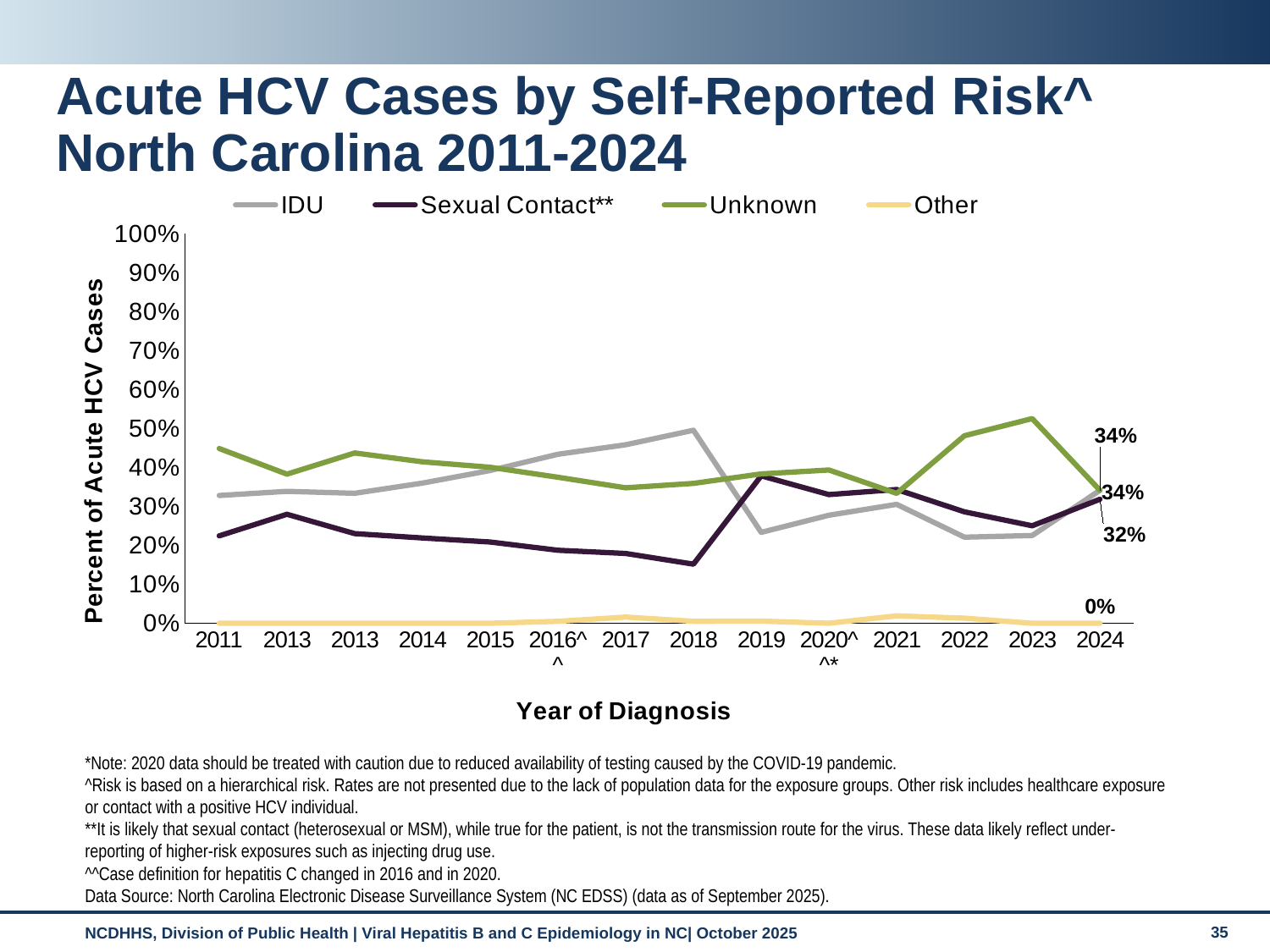
What is the value for Sexual Contact** in 2024? 32% In 2011, which is larger: IDU or Sexual Contact**? IDU How many series does the legend list? 4 Which series has the lowest value in 2023? Other What is the title of the x axis? Year of Diagnosis Is the value for IDU in 2019 greater or less than 30%? less What kind of chart is shown on the slide? line chart Is the value for Unknown in 2023 greater or less than 50%? greater How many years are shown along the x axis? 14 Is the value for Sexual Contact** in 2018 greater or less than 20%? less What is the value for Other in 2024? 0% Which series has the highest value in 2023? Unknown